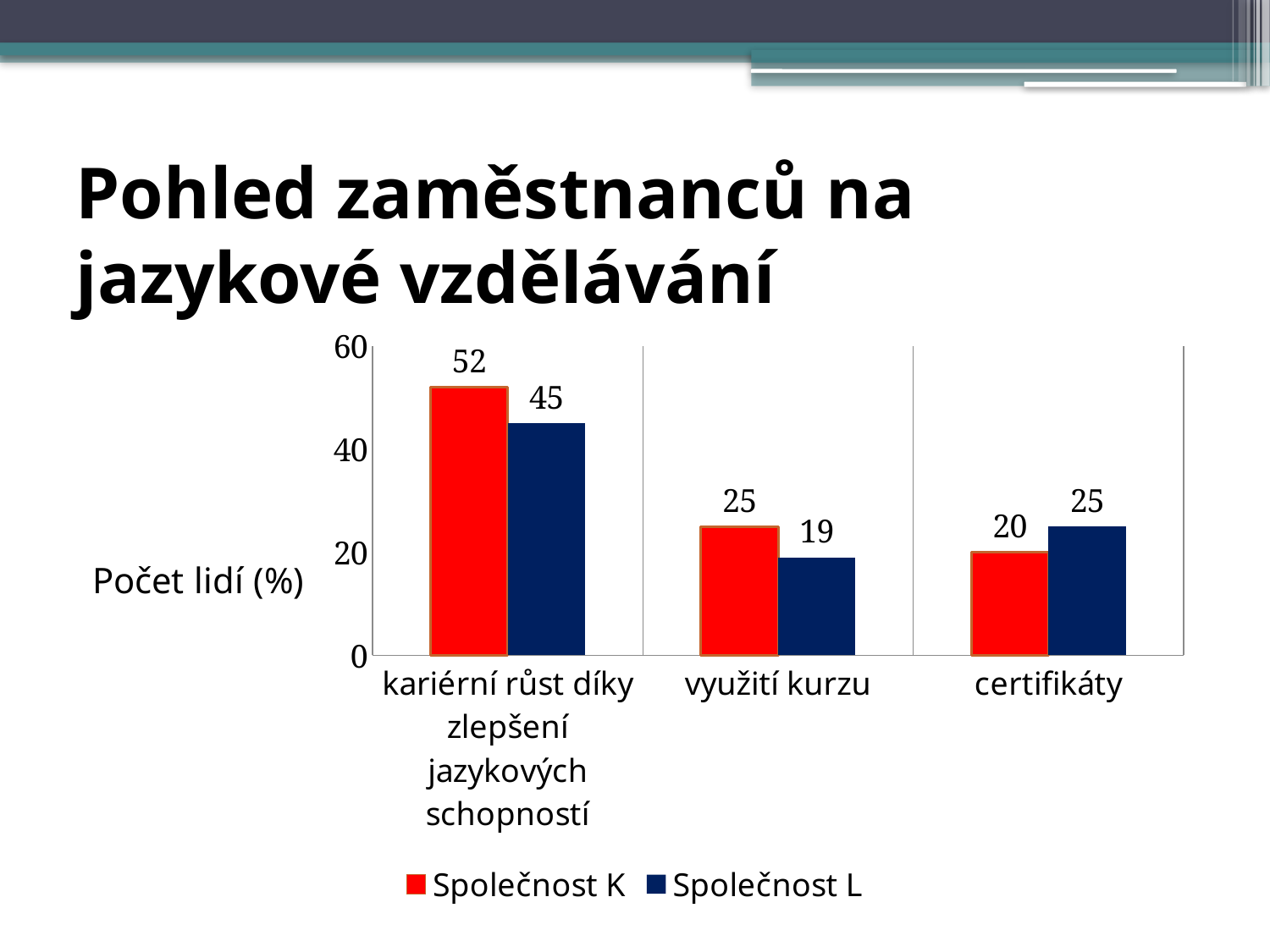
Which category has the lowest value for Společnost L? využití kurzu In the 'certifikáty' category, which series has the larger value, Společnost K or Společnost L? Společnost L What is the value for Společnost L in the 'kariérní růst díky zlepšení jazykových schopností' category? 45 What is the value for Společnost L in the 'certifikáty' category? 25 What kind of chart is shown on the slide? bar chart What is the value for Společnost K in the 'využití kurzu' category? 25 What is the difference between Společnost K and Společnost L in the 'využití kurzu' category? 6 What is the difference between Společnost K and Společnost L in the 'kariérní růst díky zlepšení jazykových schopností' category? 7 How many categories are shown on the x axis? 3 Which category has the highest value for Společnost K? kariérní růst díky zlepšení jazykových schopností Is the value for Společnost K in 'kariérní růst díky zlepšení jazykových schopností' greater or less than 40? greater How many series does the legend list? 2